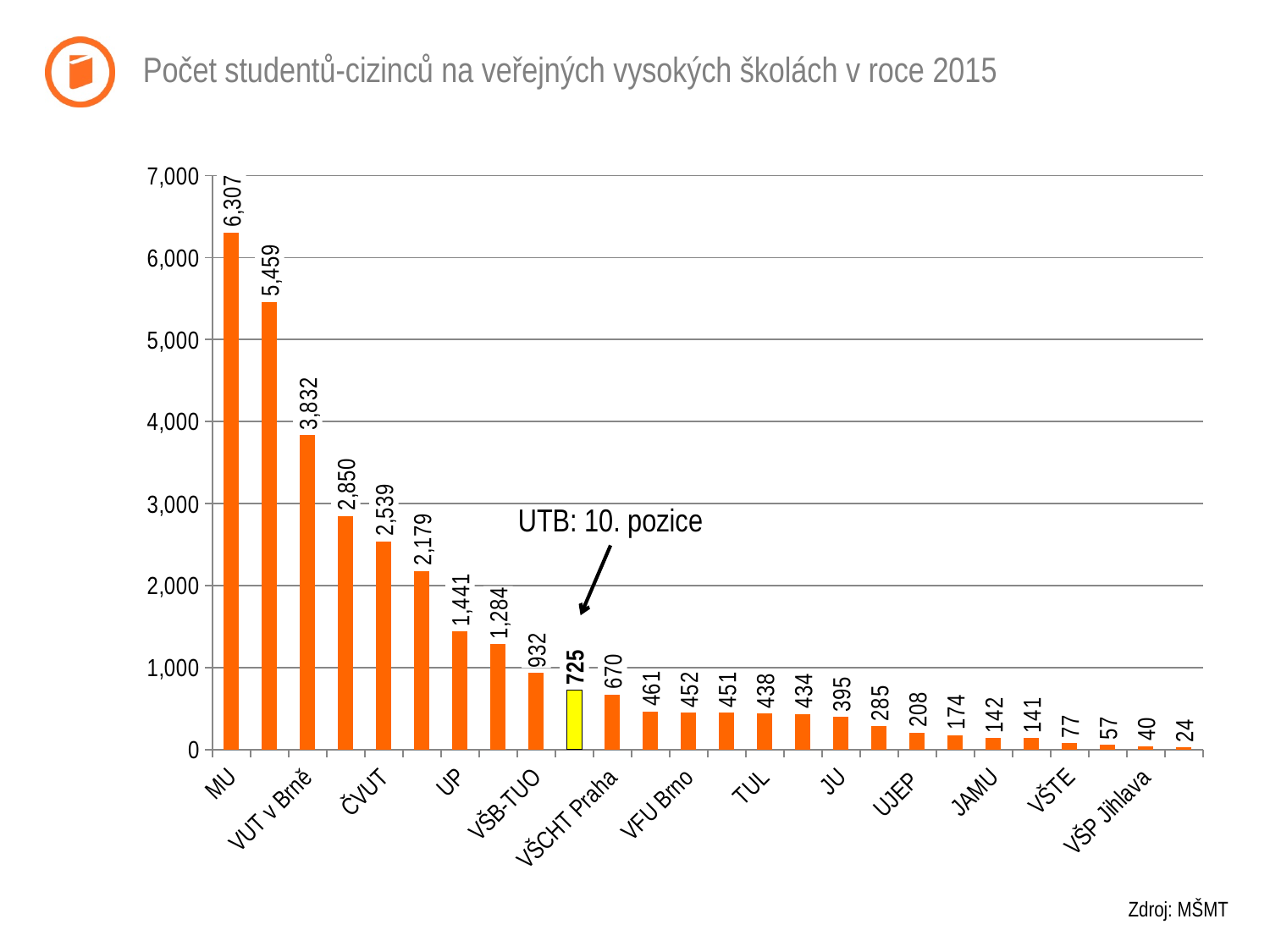
What is the value for MU? 6,307 Do the values rise or fall from left to right along the x axis? fall What position does the annotation say UTB holds? 10. pozice Which university has the highest number of foreign students? MU What type of chart is shown on the slide? bar chart What is the difference between the value for MU (6,307) and the value for UTB (725)? 5,582 What is the title of the chart? Počet studentů-cizinců na veřejných vysokých školách v roce 2015 What is the smallest value shown on the chart? 24 Is the value for MU greater or less than 6,000? greater What is the value of the highlighted yellow bar for UTB? 725 Which is larger, the value for MU or the value for VUT v Brně? MU How many bars are plotted on the chart? 26